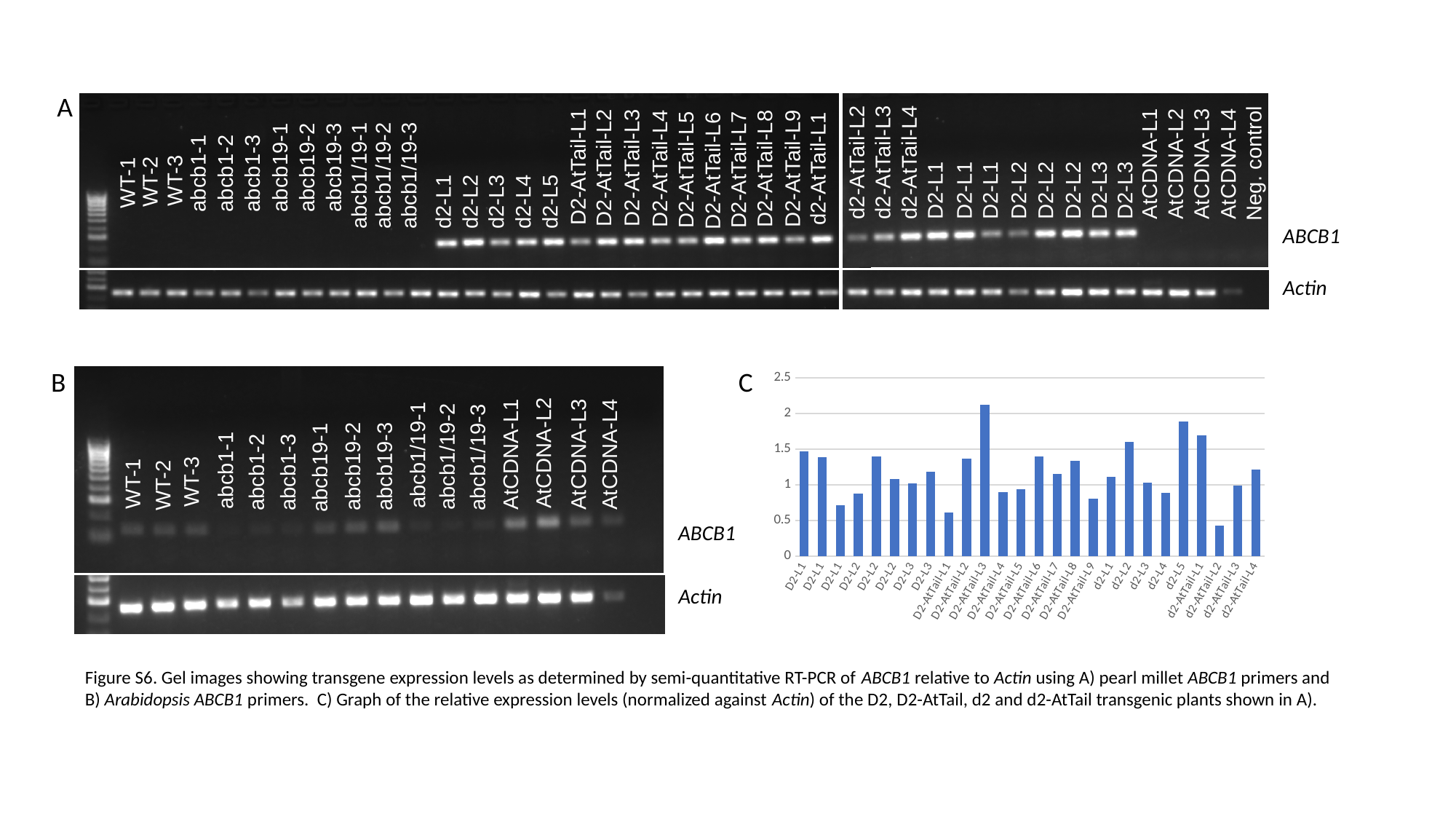
In the chart in panel C, which category has the lowest bar? d2-AtTail-L2 How many bars are plotted in the chart in panel C? 26 In the chart in panel C, is the value for d2-AtTail-L1 greater or less than 1.5? greater In the chart in panel C, which category has the highest bar? D2-AtTail-L3 In the chart in panel C, is the value for D2-AtTail-L9 greater or less than 1? less In the chart in panel C, which is larger, the value for D2-AtTail-L1 or the value for D2-AtTail-L2? D2-AtTail-L2 In the chart in panel C, is the value for d2-L5 greater or less than 1.5? greater In the chart in panel C, which is larger, the value for D2-AtTail-L3 or the value for d2-L5? D2-AtTail-L3 What kind of chart is shown in panel C? bar chart What is the highest value shown on the y axis of the chart in panel C? 2.5